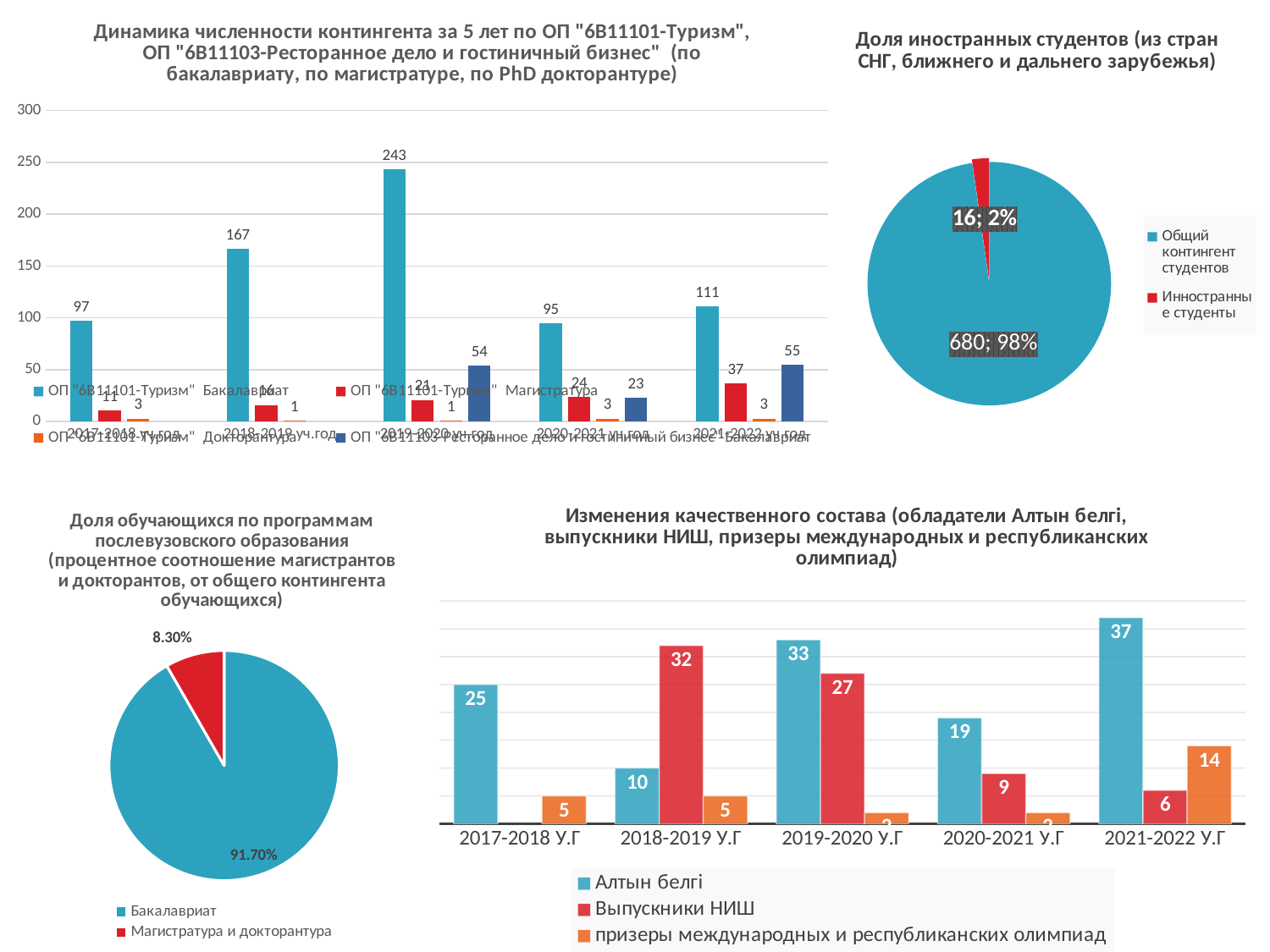
In the top-left chart "Динамика численности контингента за 5 лет", what is the value for ОП "6В11101-Туризм" Бакалавриат in 2019-2020 уч.год? 243 In the bottom-right chart "Изменения качественного состава", how many academic years are shown on the x axis? 5 In the bottom-left pie chart "Доля обучающихся по программам послевузовского образования", what share is shown for Магистратура и докторантура? 8.30% What kind of chart is the bottom-left chart "Доля обучающихся по программам послевузовского образования"? pie chart In the top-left chart "Динамика численности контингента за 5 лет", how many series does the legend list? 4 In the top-right pie chart "Доля иностранных студентов", what value and share are shown for Инностранные студенты? 16; 2% In the bottom-right chart "Изменения качественного состава", what is the value for Алтын белгі in 2021-2022 У.Г? 37 In the top-left chart "Динамика численности контингента за 5 лет", which academic year has the highest value for ОП "6В11101-Туризм" Бакалавриат? 2019-2020 уч.год In the top-left chart "Динамика численности контингента за 5 лет", what is the value for ОП "6В11101-Туризм" Магистратура in 2021-2022 уч.год? 37 In the top-right pie chart "Доля иностранных студентов", what share does Общий контингент студентов have? 98% In the bottom-right chart "Изменения качественного состава", which is larger in 2018-2019 У.Г: Алтын белгі or Выпускники НИШ? Выпускники НИШ In the top-left chart "Динамика численности контингента за 5 лет", what is the difference between the ОП "6В11101-Туризм" Бакалавриат values for 2018-2019 уч.год and 2017-2018 уч.год? 70